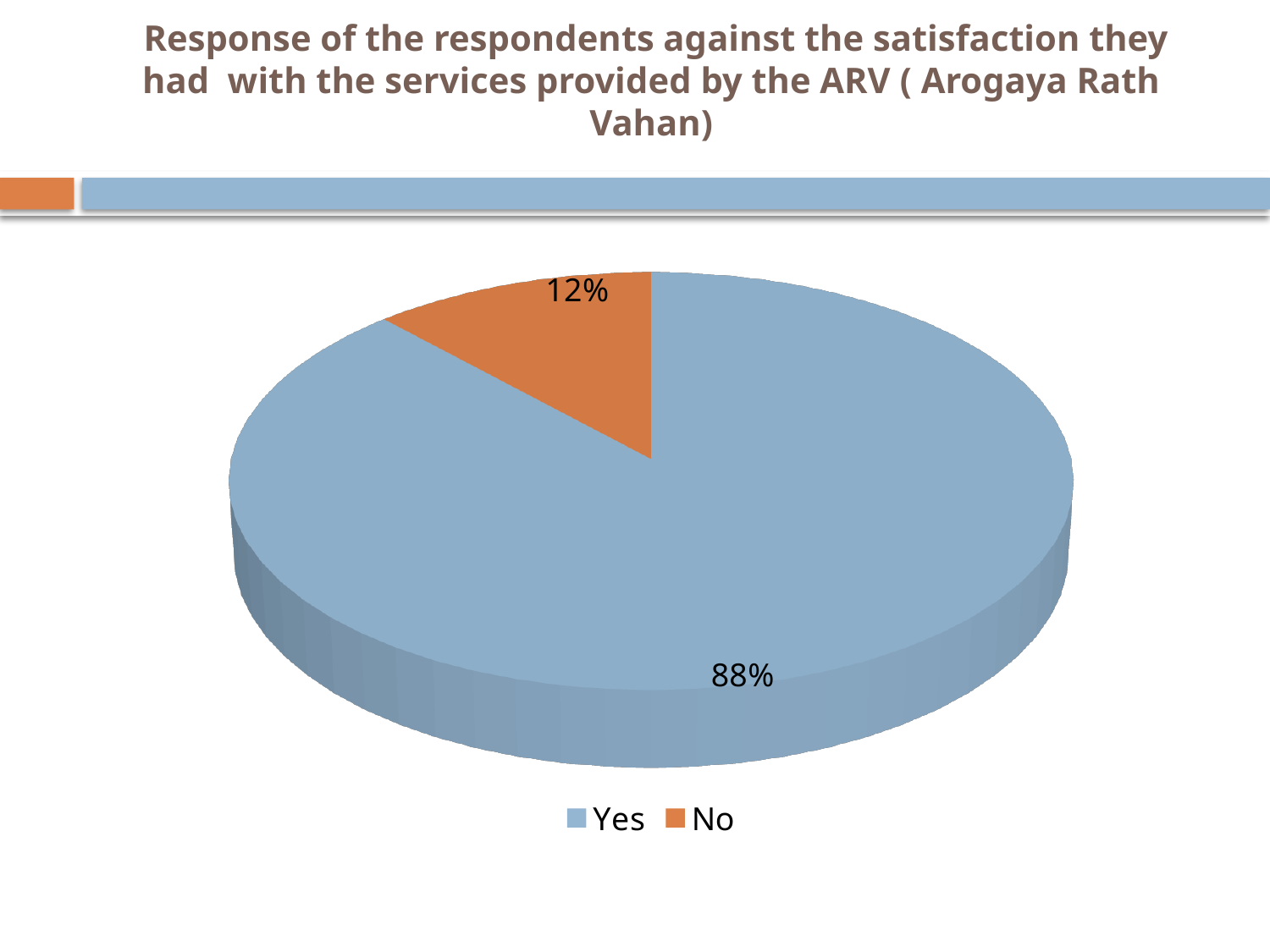
What percentage of respondents answered Yes? 88% What colour is the No slice? Orange What percentage of respondents answered No? 12% What colour is the Yes slice? Blue How many entries does the legend list? 2 How many slices does the pie chart have? 2 What share of the pie does the No slice represent? 12% Which is larger, the share for Yes or the share for No? Yes Which response has the largest share of the pie? Yes What kind of chart is shown on the slide? Pie chart What is the difference in percentage points between the Yes and No shares? 76 Which response has the smallest share of the pie? No